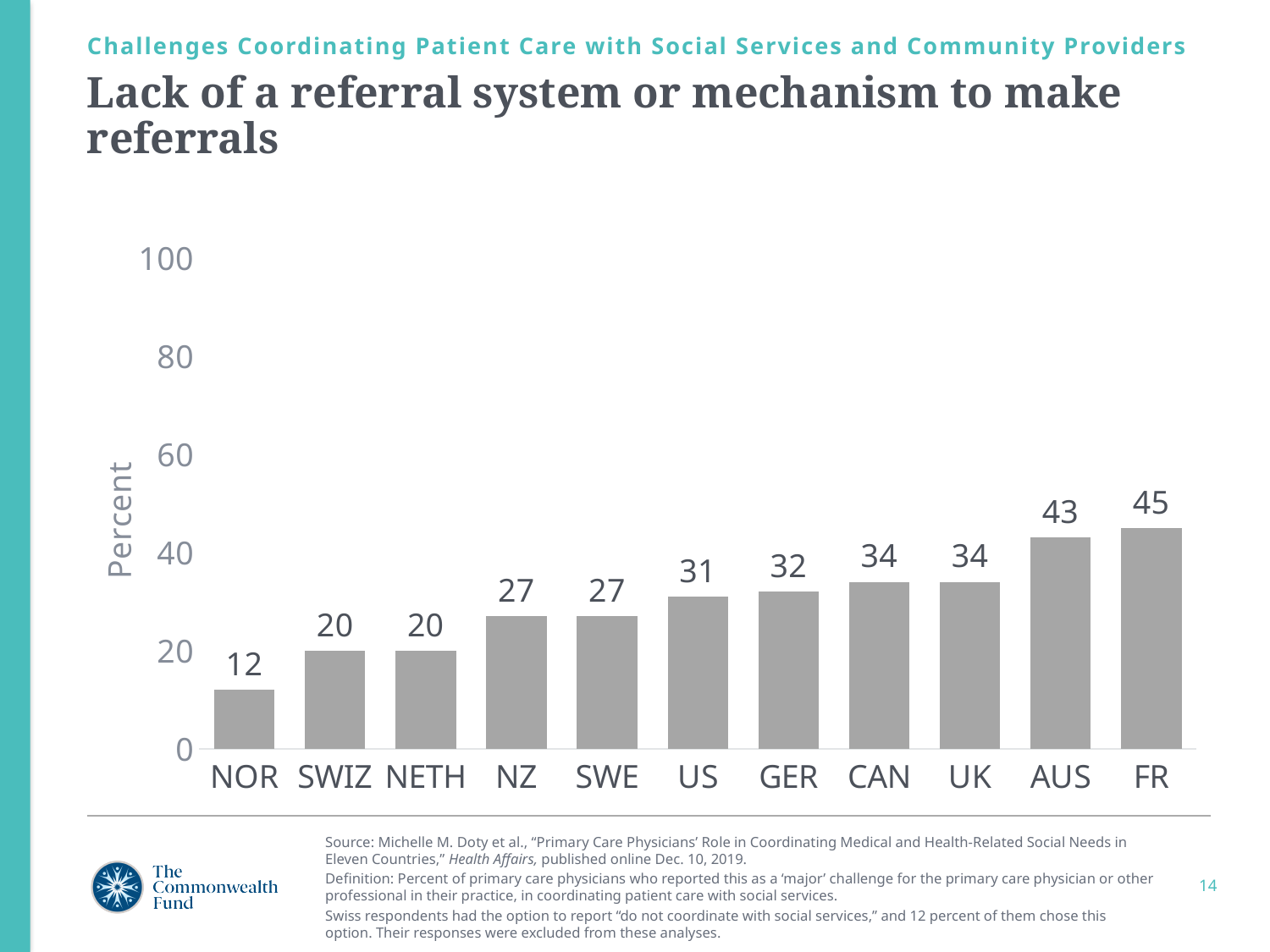
What kind of chart is shown on the slide? bar chart What is the value for US? 31 What is the value for NOR? 12 How many countries are shown on the chart? 11 Which country has the lowest value? NOR What is the label on the vertical axis? Percent What is the difference between the values for FR and NOR? 33 Which country has the highest value? FR Is the value for AUS greater or less than 40? greater Which is larger, the value for CAN or the value for SWE? CAN What is the value for FR? 45 What is the difference between the values for AUS and GER? 11